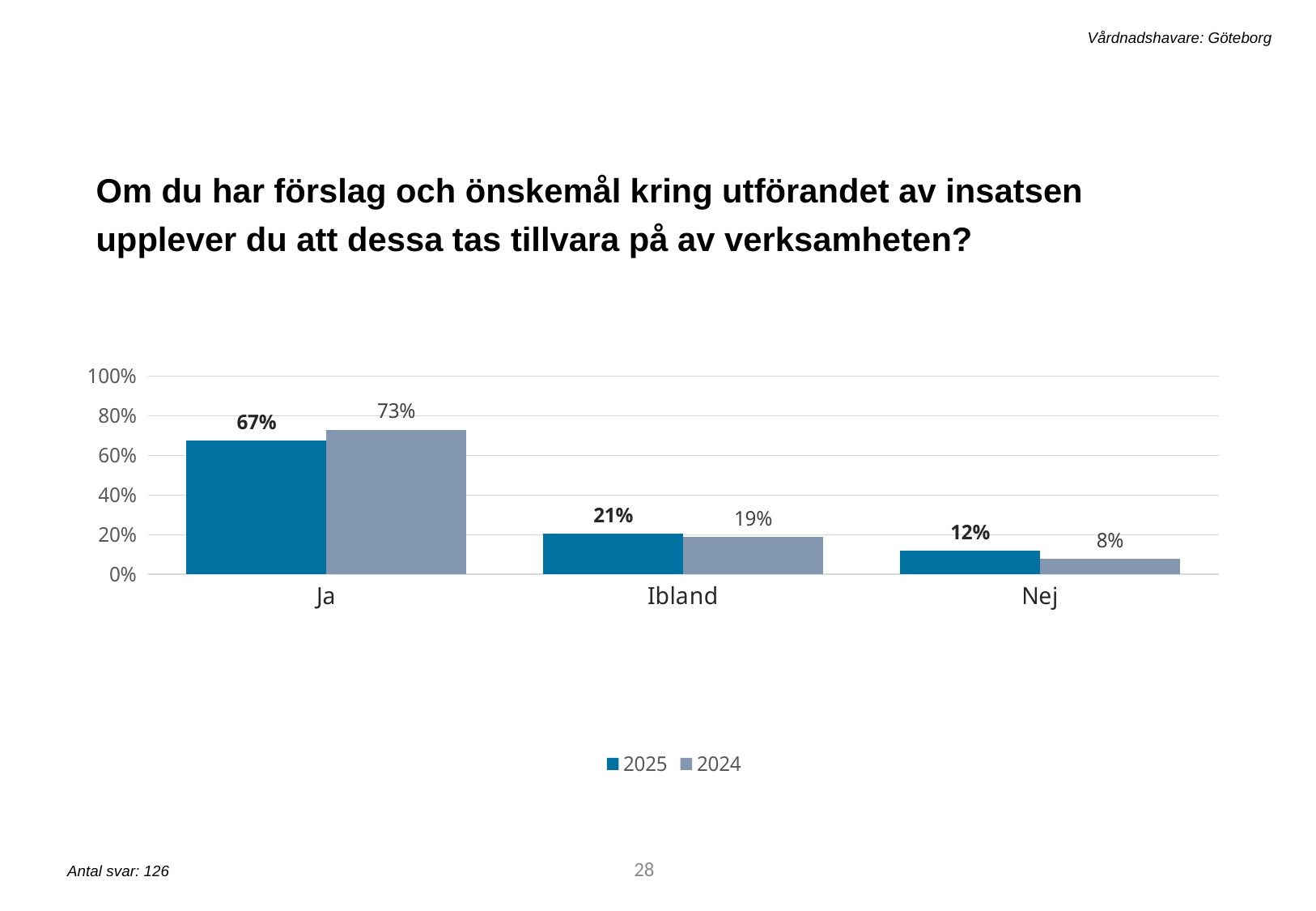
What is the value for "Ja" in the 2024 series? 73% How many series does the legend list? 2 What is the value for "Nej" in the 2024 series? 8% What is the value for "Ibland" in the 2025 series? 21% Which category has the highest value in the 2025 series? Ja What is the difference between the 2024 and 2025 values for "Ja"? 6% Which series is shown in the darker blue colour? 2025 How many categories are shown on the x axis? 3 What is the value for "Ja" in the 2025 series? 67% Which category has the lowest value in the 2024 series? Nej Which is larger for "Nej": the 2025 value or the 2024 value? 2025 What kind of chart is shown on the slide? Bar chart